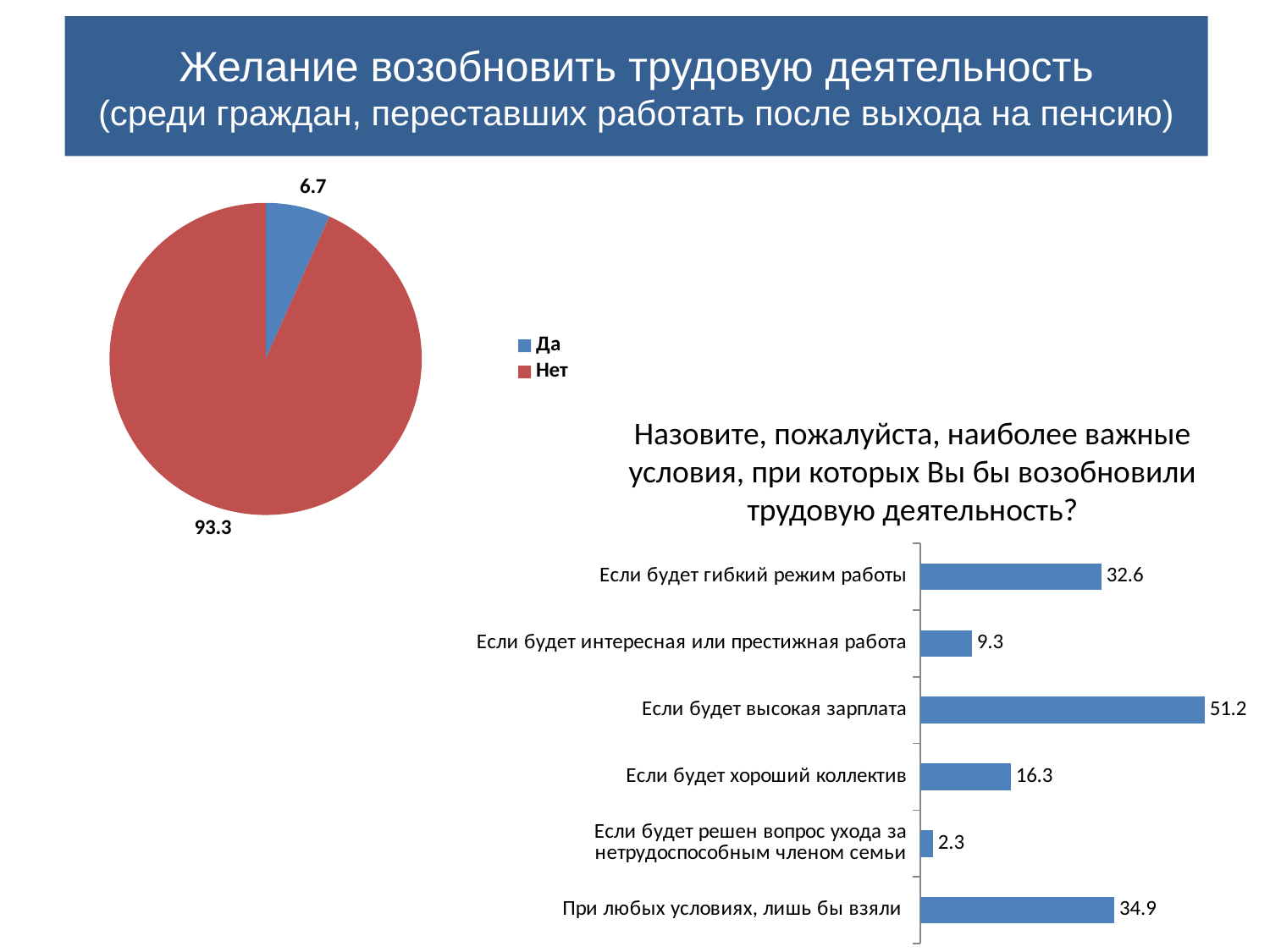
In the bar chart on the right, what is the difference between the values for "При любых условиях, лишь бы взяли" and "Если будет гибкий режим работы"? 2.3 In the pie chart on the left, which slice is larger, "Да" or "Нет"? Нет In the bar chart on the right, which category has the lowest value? Если будет решен вопрос ухода за нетрудоспособным членом семьи What kind of chart is shown on the left of the slide? Pie chart What kind of chart is shown on the right of the slide? Bar chart In the bar chart on the right, what is the value for "Если будет гибкий режим работы"? 32.6 In the pie chart on the left, how many entries does the legend list? 2 In the pie chart on the left, what is the value for "Да"? 6.7 In the bar chart on the right, how many categories are shown? 6 In the bar chart on the right, what is the value for "Если будет высокая зарплата"? 51.2 In the bar chart on the right, which category has the highest value? Если будет высокая зарплата In the pie chart on the left, what is the value for "Нет"? 93.3